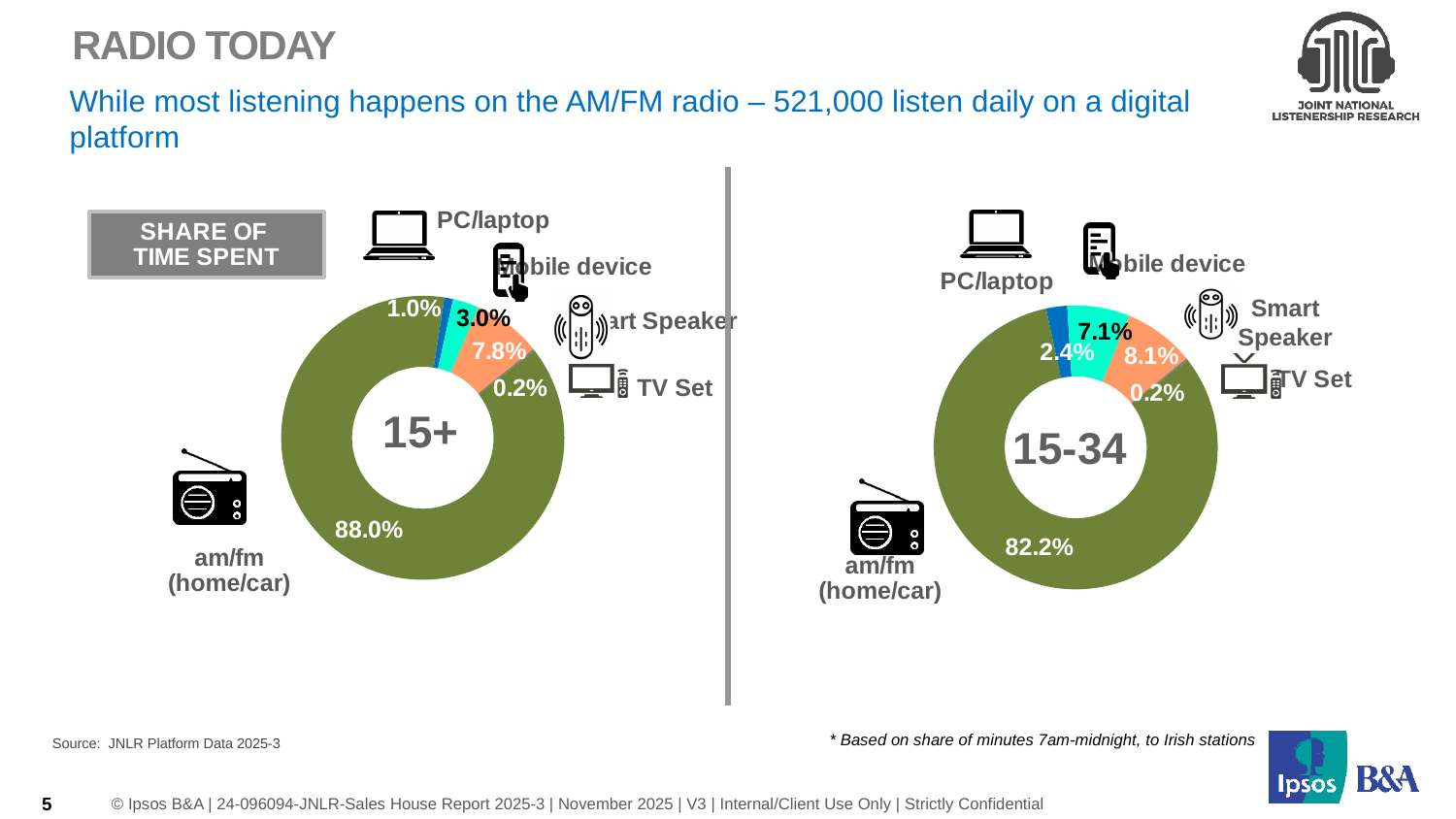
In the 15+ chart, what share of time spent is am/fm (home/car)? 88.0% What label appears in the centre of the left-hand donut chart? 15+ In the 15-34 chart, what share is shown for the Smart Speaker segment? 8.1% In the 15+ chart, which platform has the largest share of time spent? am/fm (home/car) In the 15+ chart, what is the smallest share shown? 0.2% How many percentage points higher is the am/fm (home/car) share in the 15+ chart than in the 15-34 chart? 5.8 percentage points In the 15-34 chart, what is the smallest share shown? 0.2% How many platform segments are shown in each donut chart? 5 In the 15-34 chart, what share of time spent is am/fm (home/car)? 82.2% In the 15-34 chart, which platform has the largest share of time spent? am/fm (home/car) Which chart shows a larger am/fm (home/car) share, 15+ or 15-34? 15+ What kind of chart is used on this slide? Donut (pie) chart